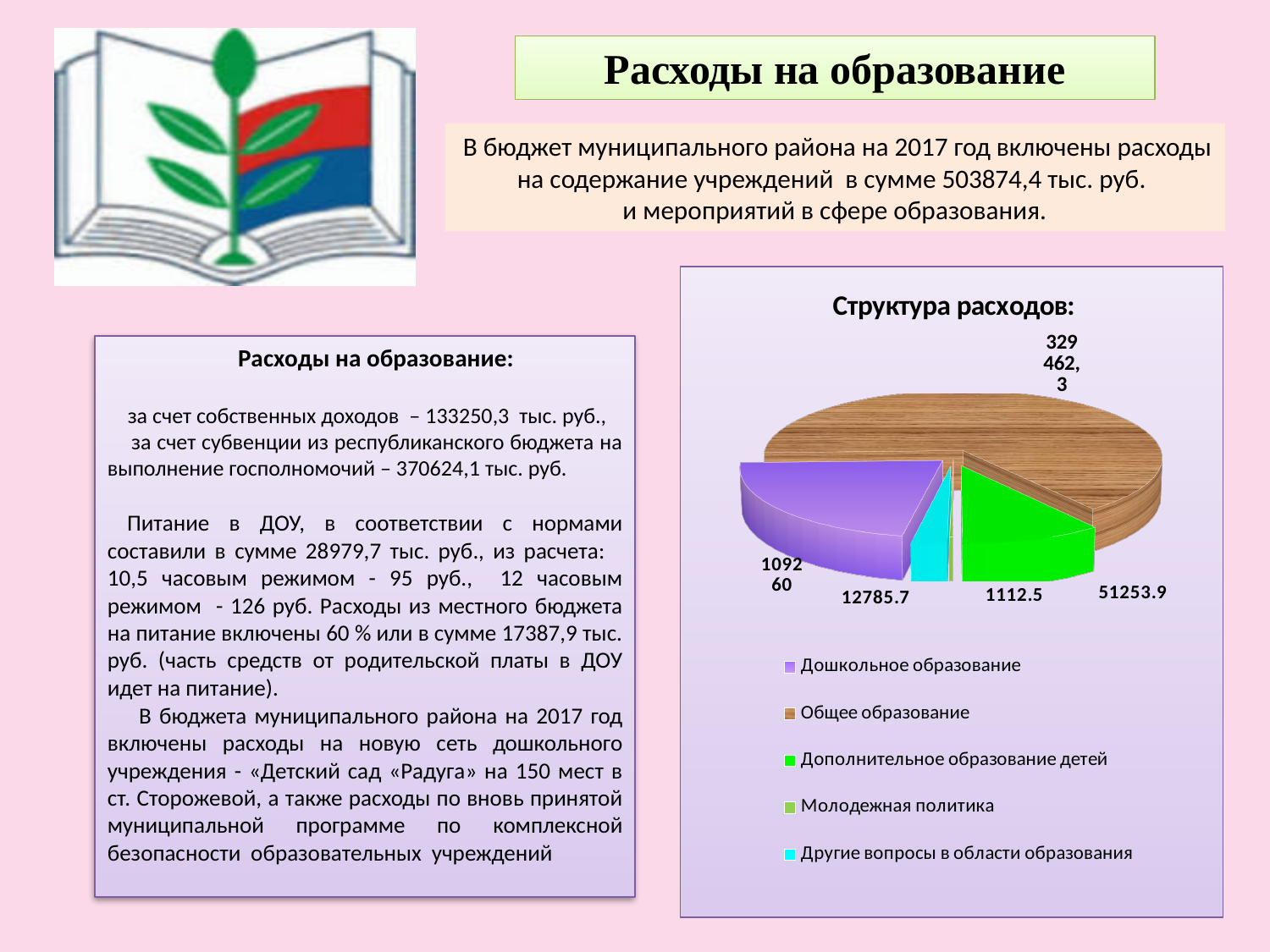
In the "Структура расходов:" chart, what is the difference between the values for "Дополнительное образование детей" and "Другие вопросы в области образования"? 38468.2 What is the value shown for "Дополнительное образование детей" in the "Структура расходов:" chart? 51253.9 How many entries does the legend of the "Структура расходов:" chart list? 5 In the "Структура расходов:" chart, which is larger: "Дошкольное образование" or "Дополнительное образование детей"? Дошкольное образование What is the value shown for "Молодежная политика" in the "Структура расходов:" chart? 1112.5 Which category has the smallest slice in the "Структура расходов:" chart? Молодежная политика What is the value shown for "Дошкольное образование" in the "Структура расходов:" chart? 109260 What kind of chart is shown under the title "Структура расходов:"? pie chart Which category has the largest slice in the "Структура расходов:" chart? Общее образование What is the value shown for "Другие вопросы в области образования" in the "Структура расходов:" chart? 12785.7 How many slices does the "Структура расходов:" pie chart have? 5 What is the value shown for "Общее образование" in the "Структура расходов:" chart? 329462,3